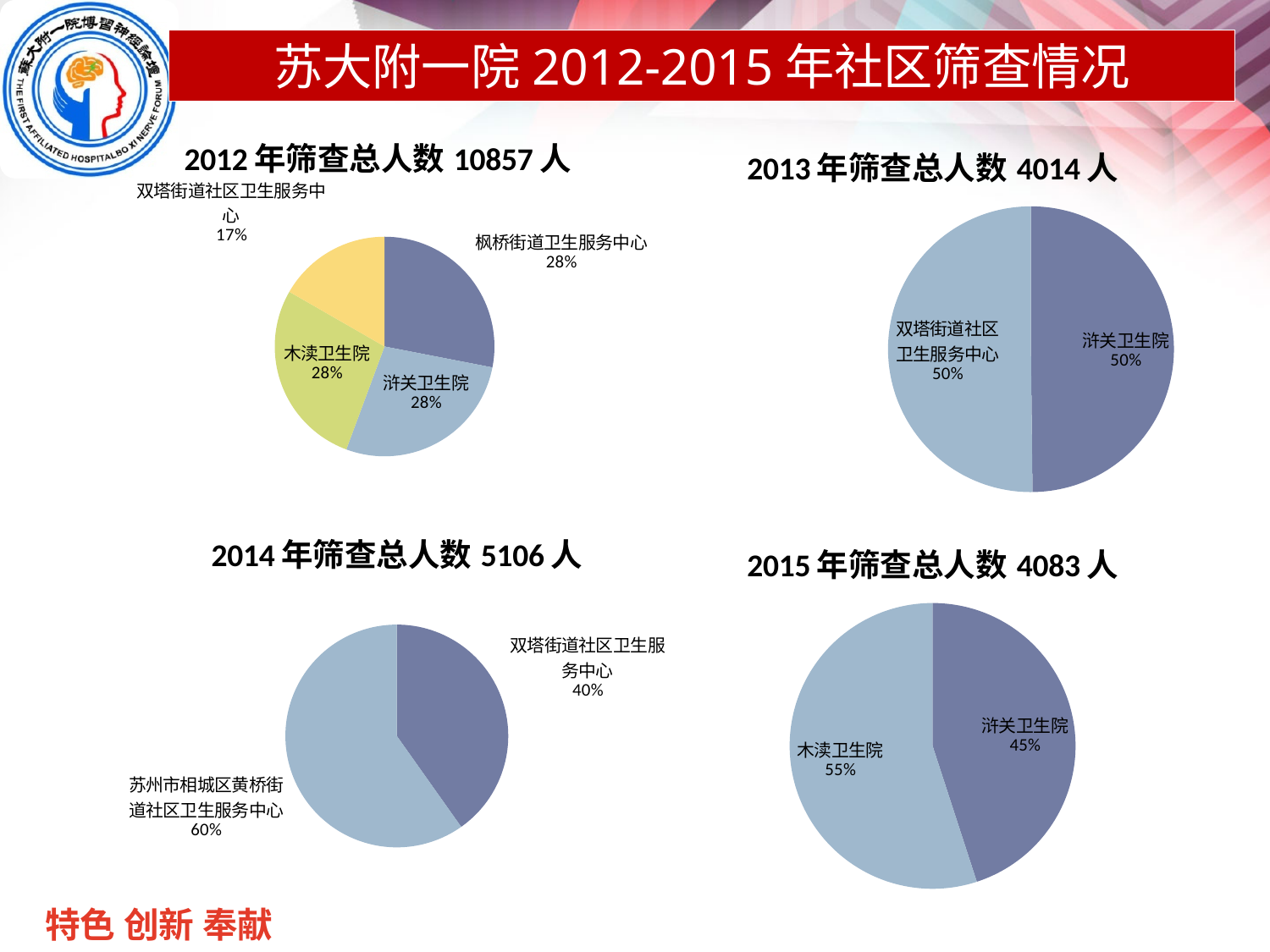
In the 2014 pie chart (2014年筛查总人数 5106人), what share does 苏州市相城区黄桥街道社区卫生服务中心 have? 60% In the 2012 pie chart, which category has the smallest share? 双塔街道社区卫生服务中心 How many slices does the 2012 pie chart have? 4 In the 2014 pie chart, which category has the larger share? 苏州市相城区黄桥街道社区卫生服务中心 How many slices does the 2013 pie chart have? 2 In the 2014 pie chart, what is the difference in percentage points between 苏州市相城区黄桥街道社区卫生服务中心 and 双塔街道社区卫生服务中心? 20 percentage points In the 2012 pie chart, what share does 枫桥街道卫生服务中心 have? 28% In the 2013 pie chart (2013年筛查总人数 4014人), what share does 浒关卫生院 have? 50% What kind of chart is used for the 2013 screening data? Pie chart In the 2015 pie chart, which is larger, 木渎卫生院 or 浒关卫生院? 木渎卫生院